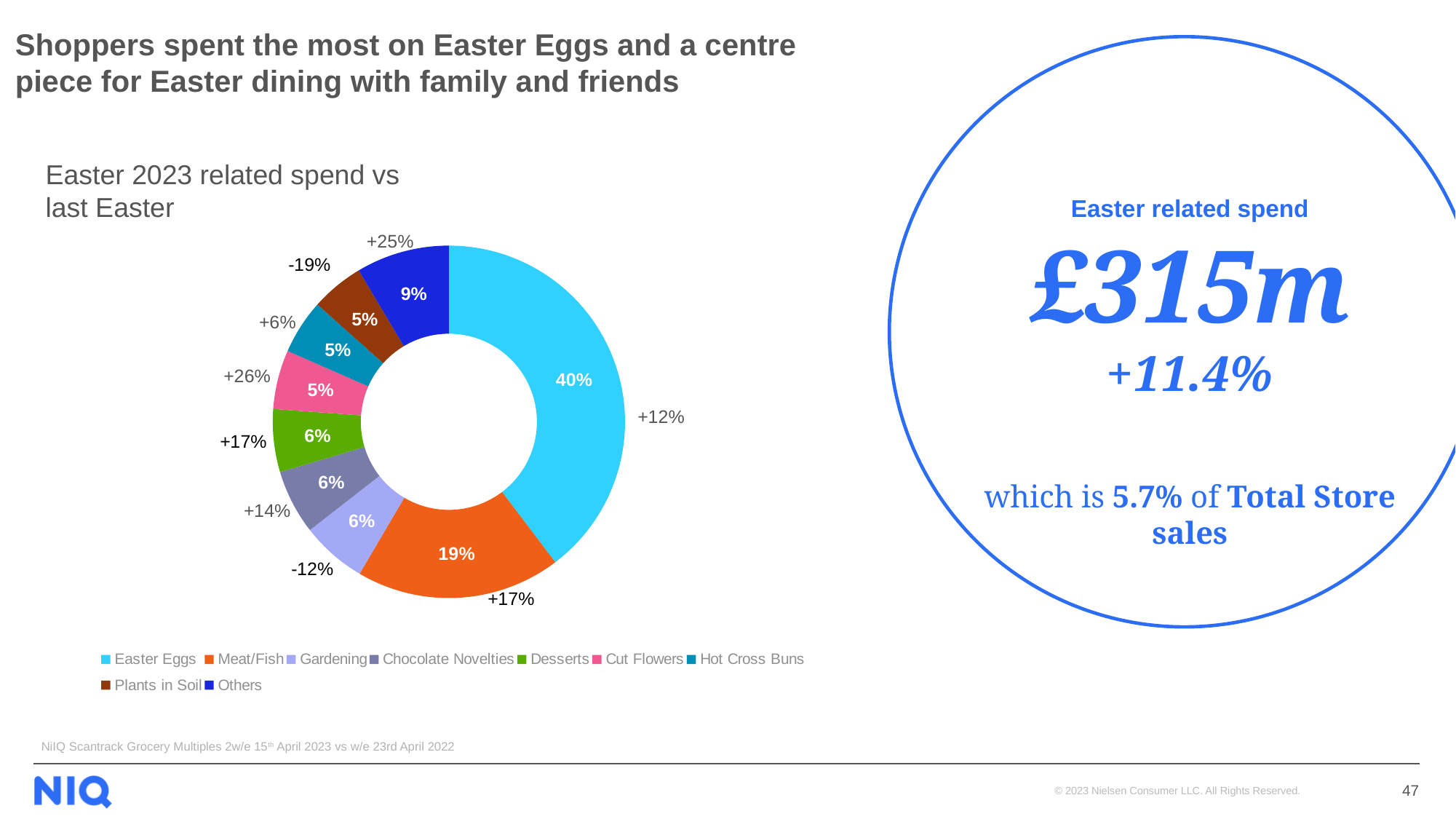
What share of Easter 2023 related spend does the Easter Eggs slice represent? 40% How many categories does the legend list? 9 What is the title of the chart? Easter 2023 related spend vs last Easter What share of the pie does Meat/Fish account for? 19% Which category has the largest slice of the pie? Easter Eggs What share of the pie does the Others slice represent? 9% What is the year-on-year change shown next to the Plants in Soil slice? -19% What is the year-on-year change shown next to the Gardening slice? -12% What is the difference in share between the Easter Eggs slice and the Meat/Fish slice? 21 percentage points What is the year-on-year change shown next to the Cut Flowers slice? +26% Which slice is larger, Others or Desserts? Others What kind of chart is shown on the slide? Pie chart (donut)